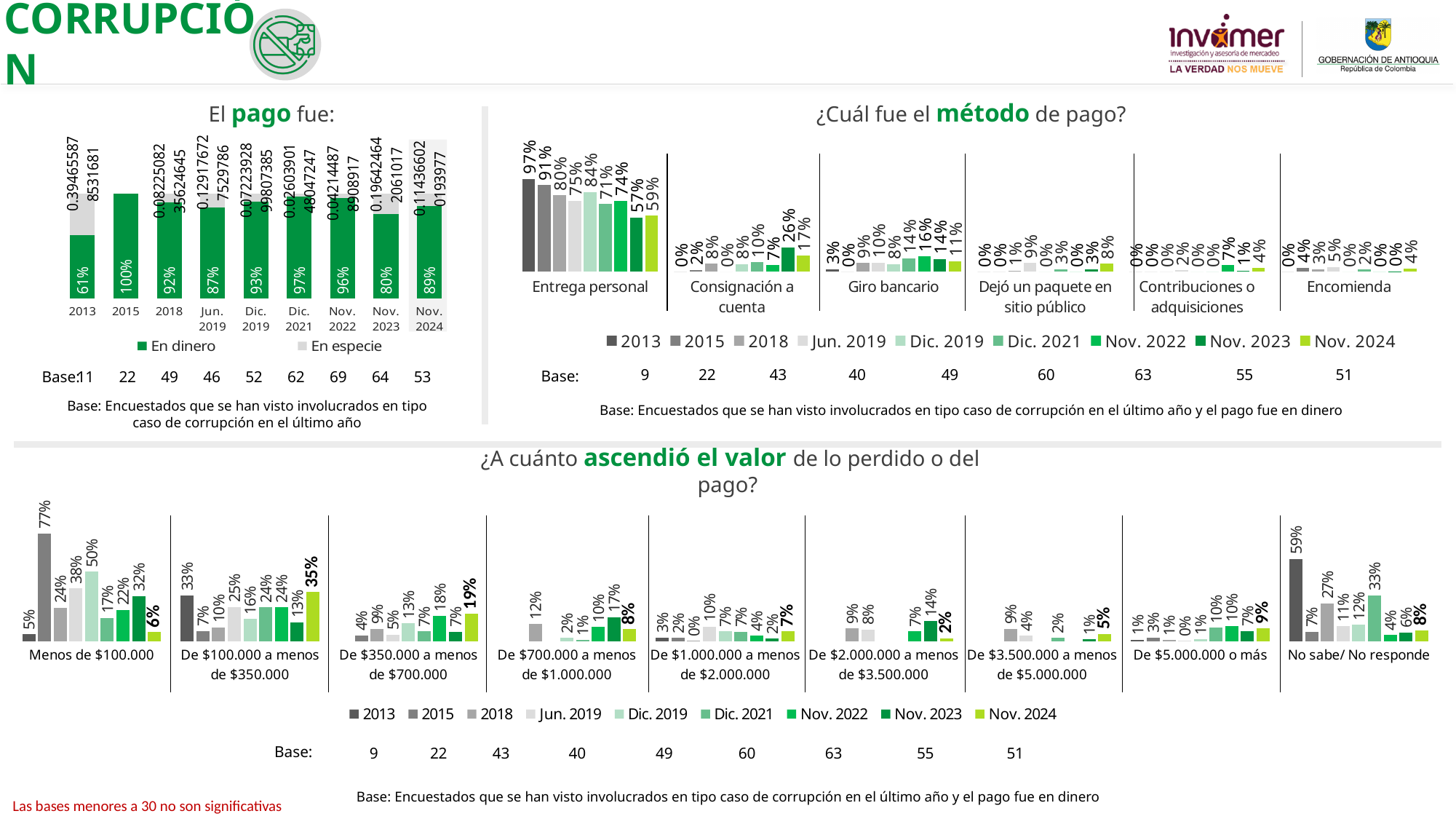
In the chart '¿Cuál fue el método de pago?', how many payment method categories are shown? 6 In the chart '¿A cuánto ascendió el valor de lo perdido o del pago?', what is the value for 'No sabe/ No responde' in 2013? 59% In the chart '¿Cuál fue el método de pago?', which payment method has the highest value for Nov. 2024? Entrega personal In the chart 'El pago fue:', what percentage of payments were 'En dinero' in 2015? 100% In the chart '¿Cuál fue el método de pago?', what is the value for 'Entrega personal' in 2013? 97% In the chart '¿A cuánto ascendió el valor de lo perdido o del pago?', which category has the highest value for Nov. 2024? De $100.000 a menos de $350.000 In the chart '¿Cuál fue el método de pago?', what is the value for 'Consignación a cuenta' in Nov. 2023? 26% In the chart 'El pago fue:', what is the 'En dinero' value for Nov. 2024? 89% In the chart '¿A cuánto ascendió el valor de lo perdido o del pago?', what is the value for 'Menos de $100.000' in 2015? 77% In the chart 'El pago fue:', which year has the lowest 'En dinero' percentage? 2013 In the chart 'El pago fue:', by how many percentage points does the 'En dinero' value for Nov. 2024 exceed that of Nov. 2023? 9 percentage points In the chart 'El pago fue:', how many series does the legend list? 2